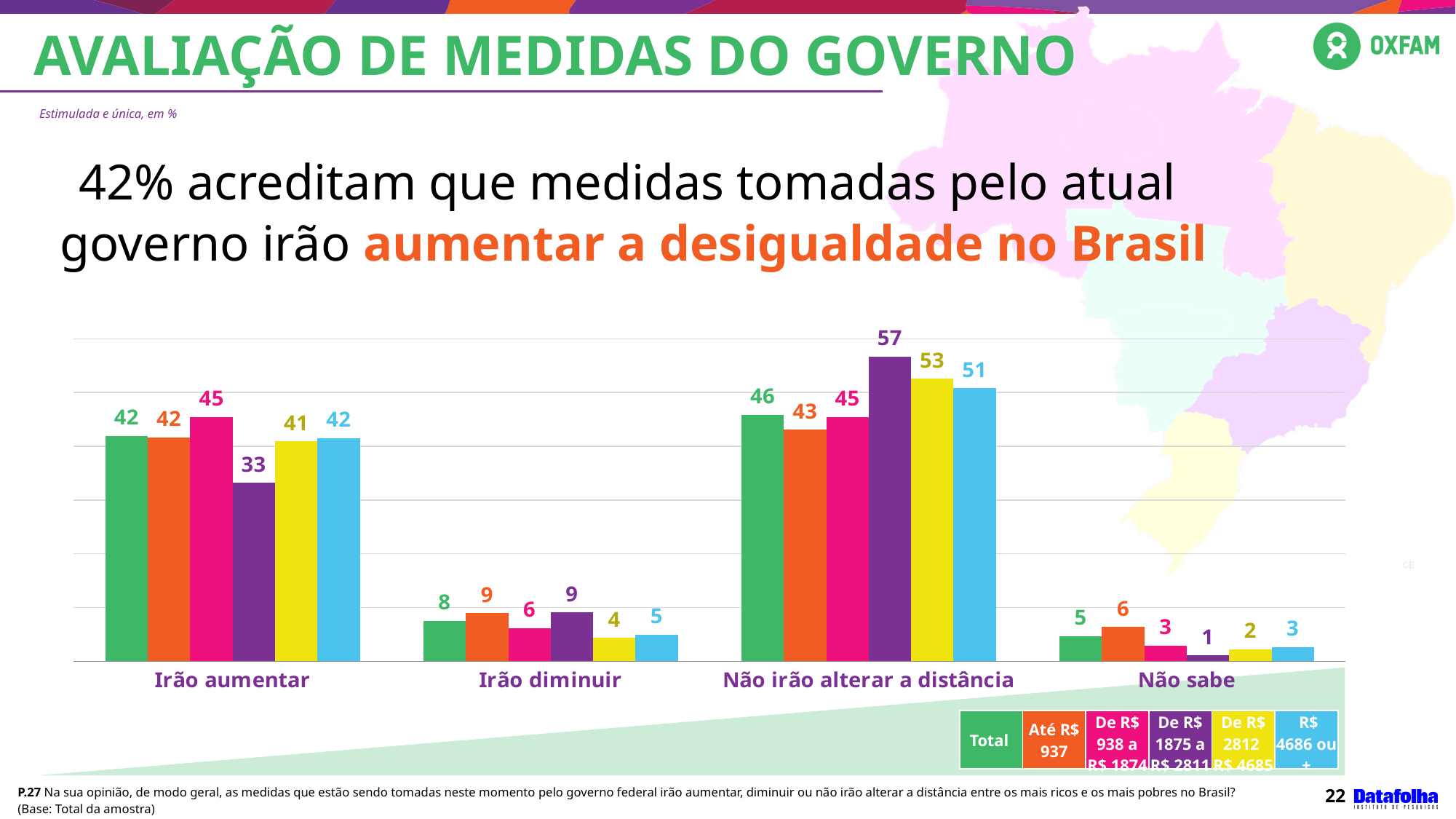
Which series has the highest value in the "Não irão alterar a distância" category? De R$ 1875 a R$ 2811 What kind of chart is shown on the slide? bar chart What is the value for the "R$ 4686 ou +" series in the "Não sabe" category? 3 What is the value for the "De R$ 1875 a R$ 2811" series in the "Não irão alterar a distância" category? 57 What is the value for the "Até R$ 937" series in the "Irão diminuir" category? 9 In the "Não sabe" category, is the value for "Até R$ 937" larger or smaller than the value for "De R$ 1875 a R$ 2811"? larger What is the difference between the "De R$ 1875 a R$ 2811" value and the Total value in the "Não irão alterar a distância" category? 11 How many categories are shown on the x axis of the chart? 4 What is the Total value for "Irão aumentar"? 42 Which series has the lowest value in the "Irão aumentar" category? De R$ 1875 a R$ 2811 How many series does the chart legend list? 6 Which colour represents the Total series in the chart? green